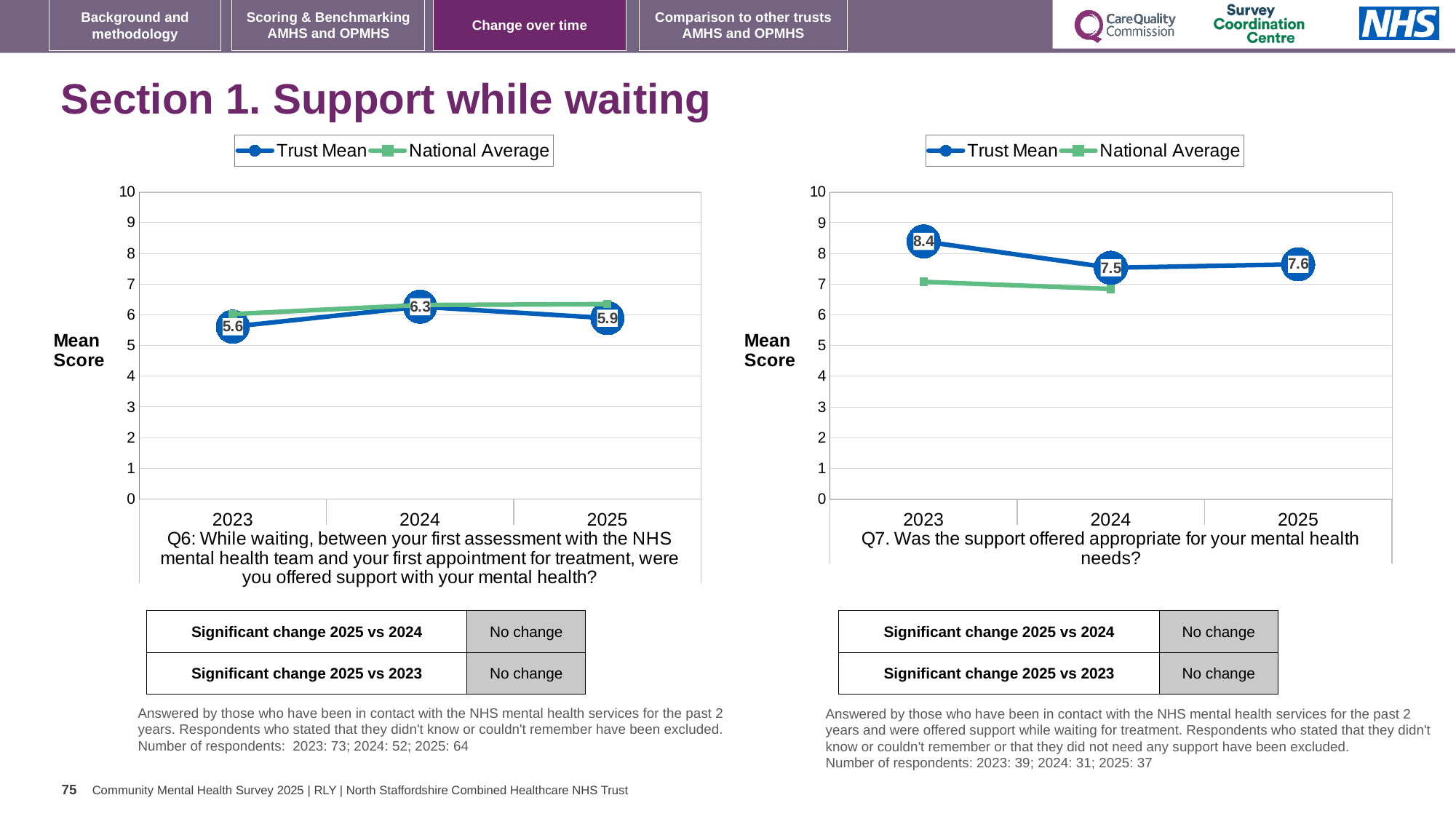
On the right chart (Q7), what is the Trust Mean score for 2025? 7.6 On the right chart (Q7), what is the difference between the Trust Mean scores for 2023 and 2024? 0.9 On the left chart (Q6), is the Trust Mean score higher in 2024 or in 2025? 2024 On the left chart (Q6), which year has the lowest Trust Mean score? 2023 On the right chart (Q7), does the Trust Mean score rise or fall from 2023 to 2024? Fall On the right chart (Q7), is the National Average value for 2024 greater or less than 7? less On the left chart (Q6), what is the Trust Mean score for 2024? 6.3 How many series does the legend of the right chart (Q7) list? 2 On the left chart (Q6), what is the Trust Mean score for 2023? 5.6 On the left chart (Q6), how many years are shown on the x axis? 3 What type of chart is the left chart (Q6)? Line chart On the right chart (Q7), which year has the highest Trust Mean score? 2023